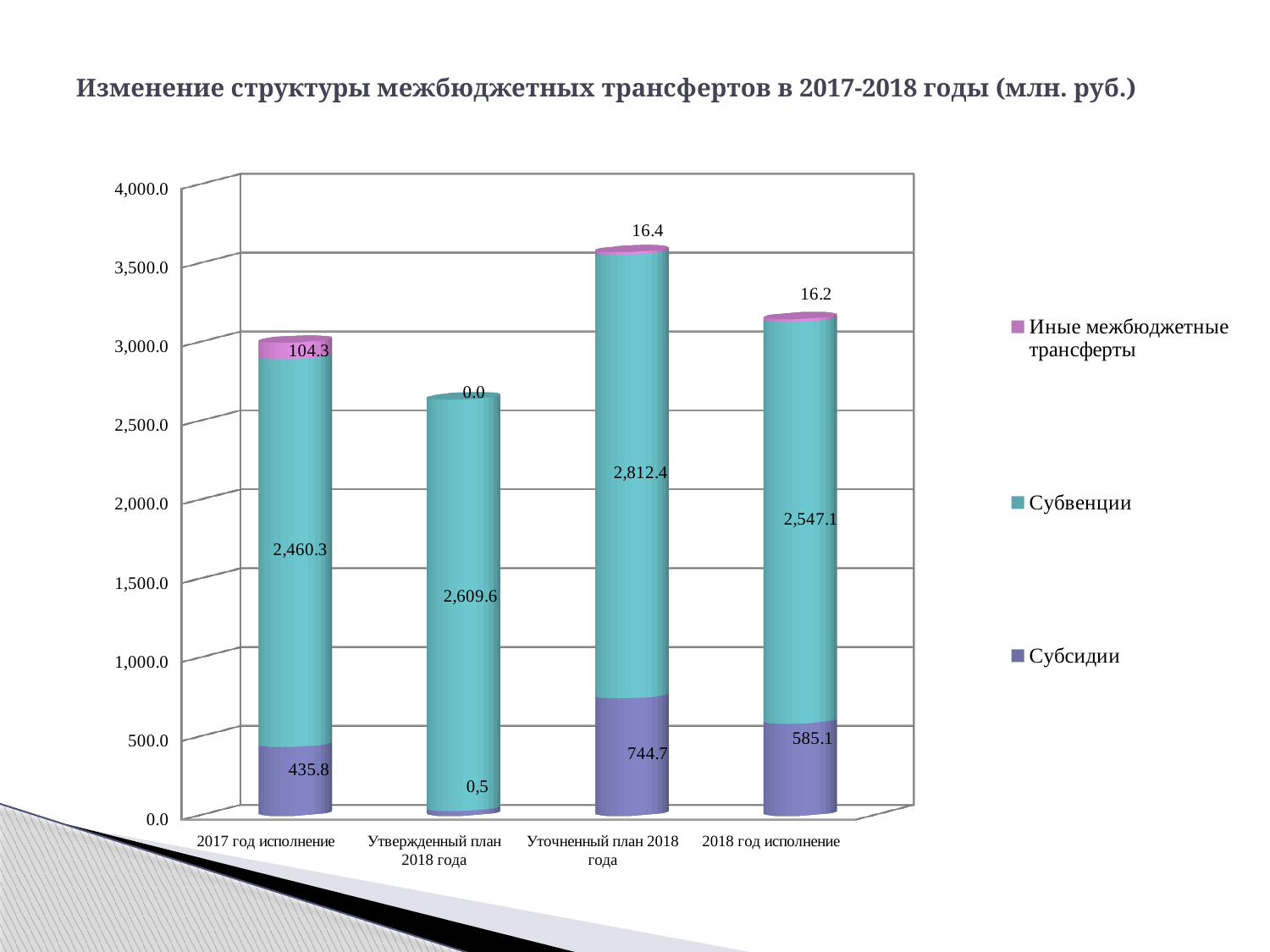
Which category has the lowest value for Субсидии? Утвержденный план 2018 года What is the value of Субсидии for Уточненный план 2018 года? 744.7 What is the title of the chart? Изменение структуры межбюджетных трансфертов в 2017-2018 годы (млн. руб.) Which is larger: Субвенции for 2018 год исполнение or Субвенции for Утвержденный план 2018 года? Утвержденный план 2018 года What is the difference between Субсидии for Уточненный план 2018 года and 2018 год исполнение? 159.6 What is the total of the stacked bar for 2017 год исполнение? 3,000.4 What is the value of Субвенции for 2017 год исполнение? 2,460.3 How many series does the legend list? 3 Which category has the highest value for Субвенции? Уточненный план 2018 года What type of chart is shown on the slide? Stacked bar chart How many categories are shown on the x axis? 4 What is the value of Иные межбюджетные трансферты for 2018 год исполнение? 16.2